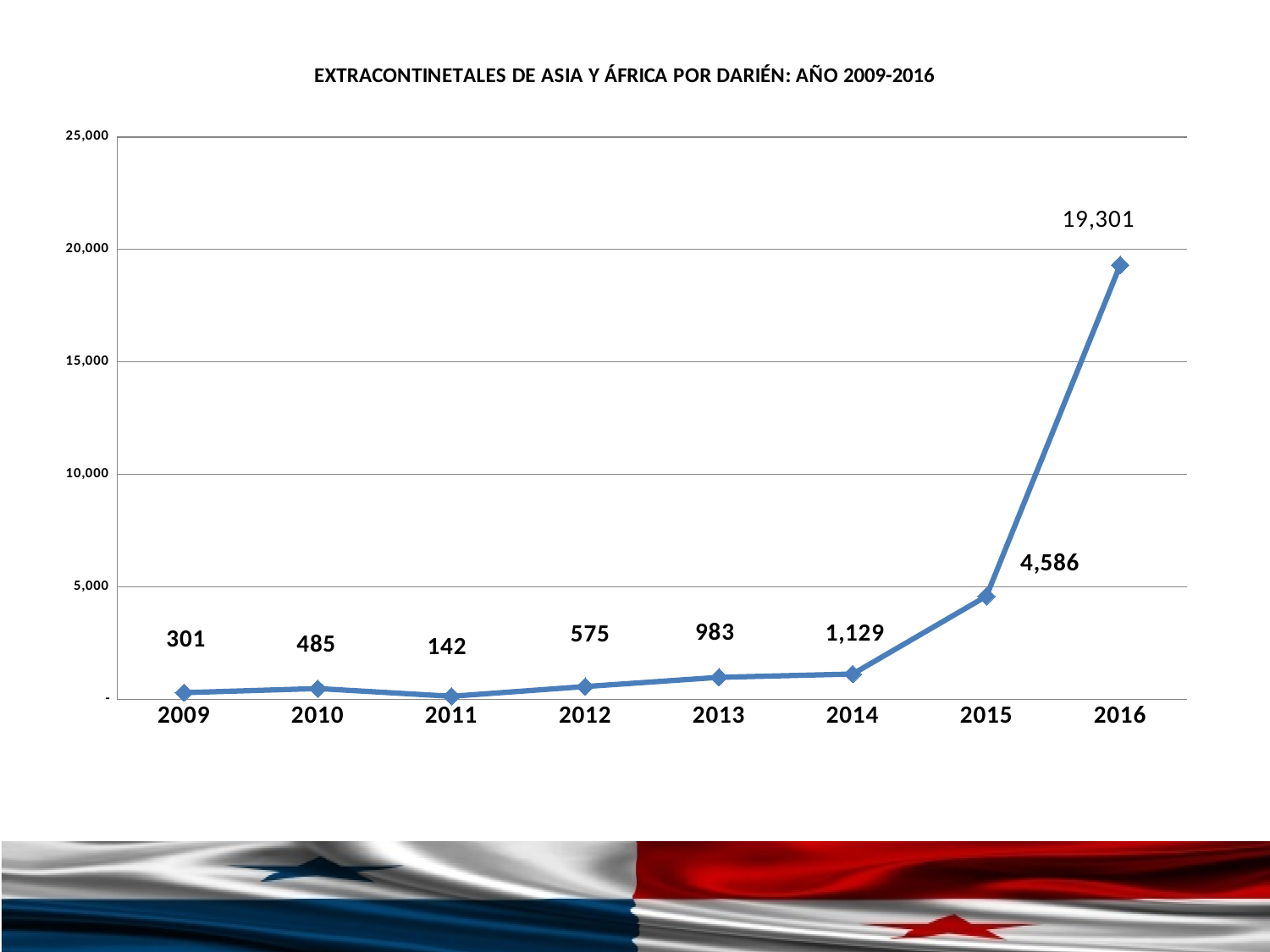
Which year has the lowest value? 2011 Which is larger, the value for 2013 or the value for 2012? 2013 Do the values rise or fall from 2014 to 2016? rise Is the value for 2015 greater or less than 5,000? less Which year has the highest value? 2016 What kind of chart is shown on the slide? line chart What is the value for 2016? 19,301 How many years are plotted on the chart? 8 What is the difference between the values for 2010 and 2009? 184 What is the value for 2011? 142 What is the difference between the values for 2016 and 2015? 14,715 What is the value for 2014? 1,129